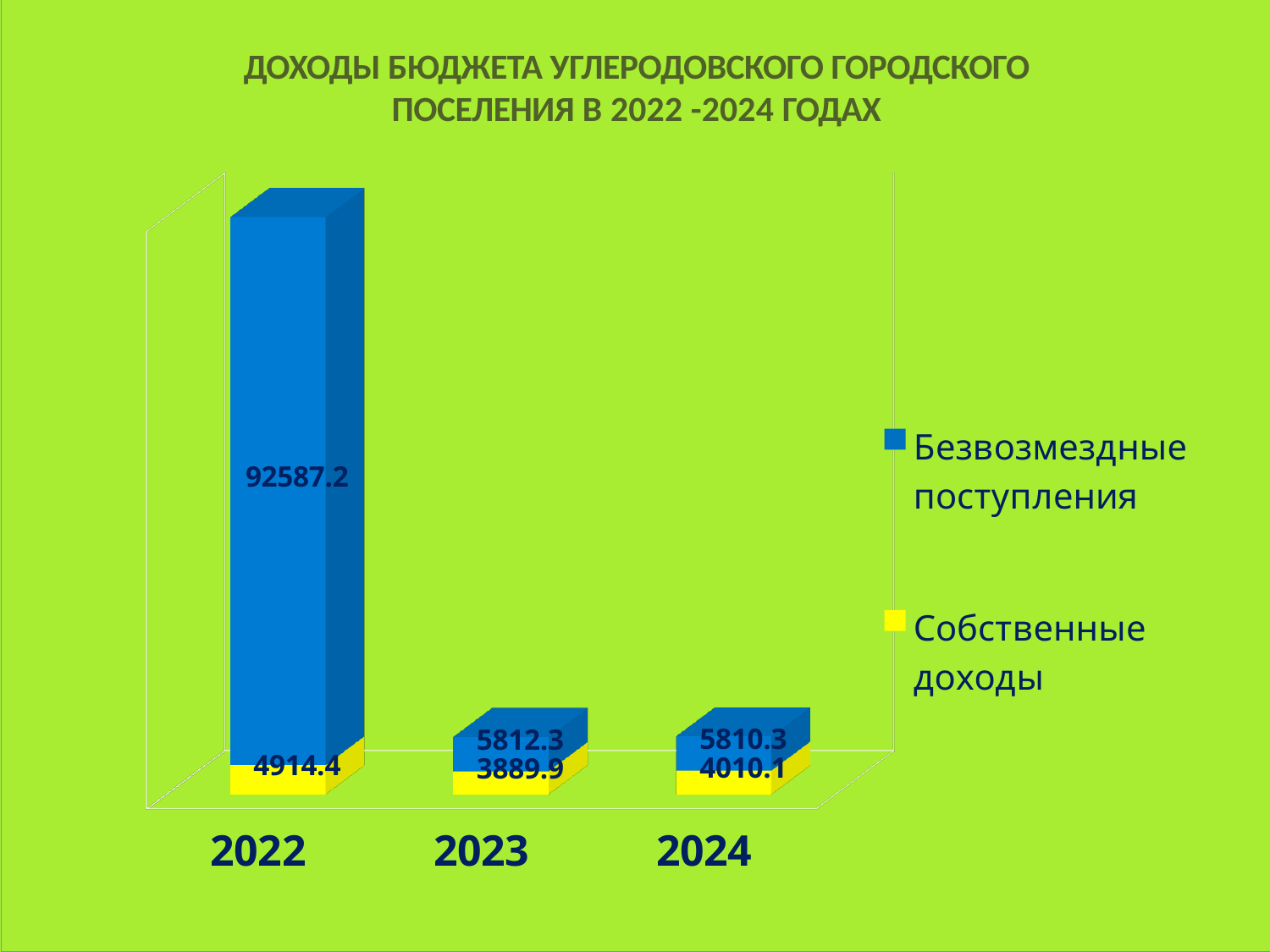
What is the difference between Собственные доходы in 2022 and in 2024? 904.3 What is the total of the stacked bar for 2023? 9702.2 What kind of chart is shown on the slide? Stacked bar chart What is the value of Собственные доходы for 2023? 3889.9 What is the value of Безвозмездные поступления for 2023? 5812.3 In which year is Безвозмездные поступления highest? 2022 What is the value of Безвозмездные поступления for 2022? 92587.2 Which is larger: Собственные доходы in 2022 or in 2024? 2022 What is the value of Собственные доходы for 2024? 4010.1 In which year is Собственные доходы lowest? 2023 What is the difference between Безвозмездные поступления in 2022 and in 2023? 86774.9 How many series does the legend list? 2